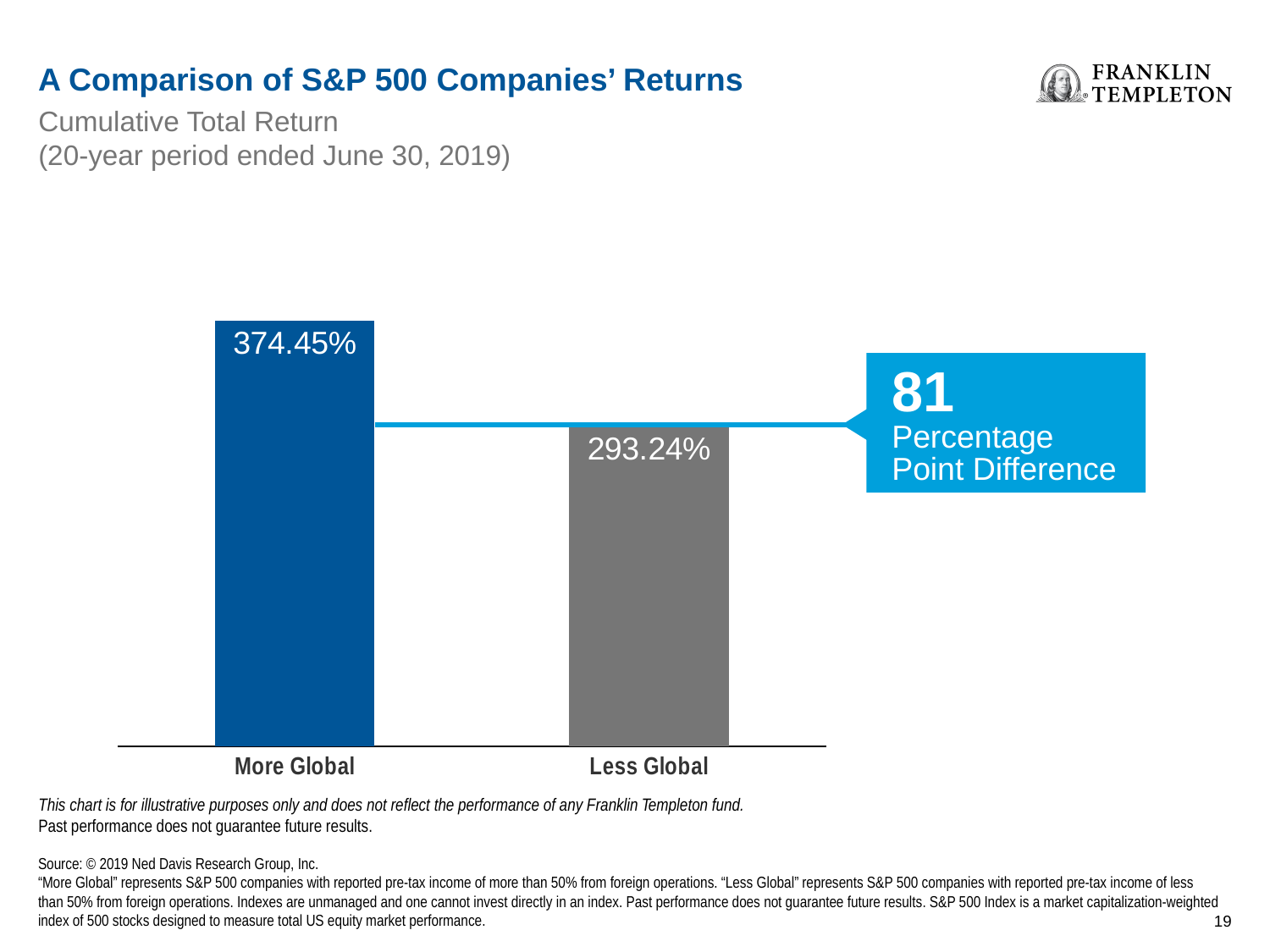
Which category has the lower cumulative total return? Less Global How many categories are shown in the chart? 2 Which category has the higher cumulative total return? More Global What is the difference in percentage points between the More Global and Less Global returns? 81.21 Over what period is the cumulative total return measured? 20-year period ended June 30, 2019 What percentage point difference does the callout box on the chart state? 81 What is the cumulative total return for Less Global companies? 293.24% What is the title of the slide containing the chart? A Comparison of S&P 500 Companies' Returns What is the cumulative total return for More Global companies? 374.45% Is the return for More Global larger or smaller than the return for Less Global? larger What type of chart is shown on the slide? bar chart